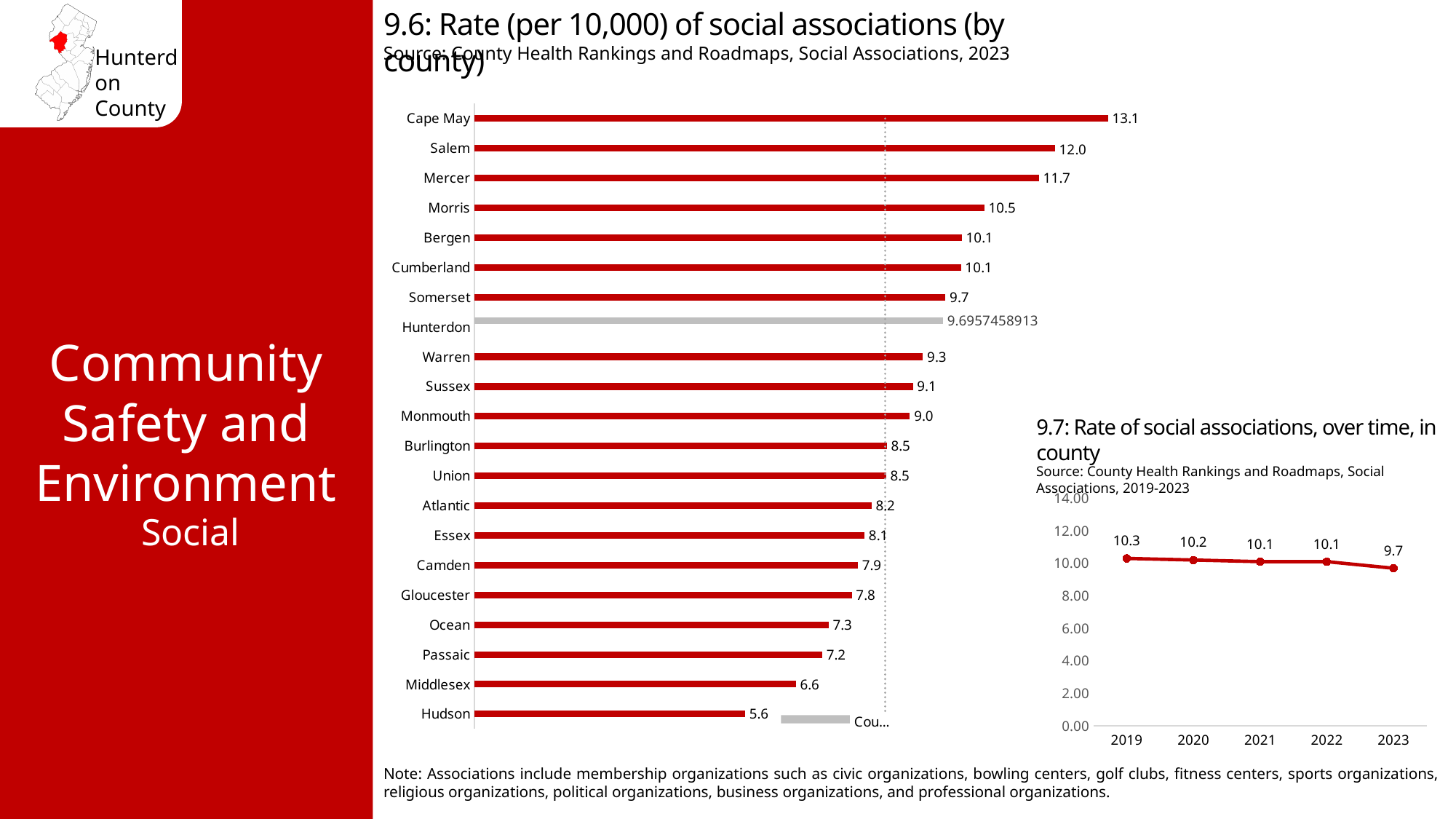
In chart 9.6 (rate of social associations by county), what is the value for Cape May? 13.1 In chart 9.7 (rate of social associations over time), what is the value for 2023? 9.7 In chart 9.6 (rate of social associations by county), what is the difference between Salem and Middlesex? 5.4 What kind of chart is chart 9.6 (rate of social associations by county)? Bar chart In chart 9.6 (rate of social associations by county), how many counties are shown? 21 In chart 9.7 (rate of social associations over time), do the values rise or fall from 2019 to 2023? Fall In chart 9.6 (rate of social associations by county), what is the value for Gloucester? 7.8 In chart 9.7 (rate of social associations over time), how many years are plotted? 5 In chart 9.6 (rate of social associations by county), which county has the lowest rate? Hudson In chart 9.7 (rate of social associations over time), what is the difference between the 2019 and 2023 values? 0.6 In chart 9.6 (rate of social associations by county), which county has the highest rate? Cape May In chart 9.6 (rate of social associations by county), which has a higher rate, Morris or Warren? Morris